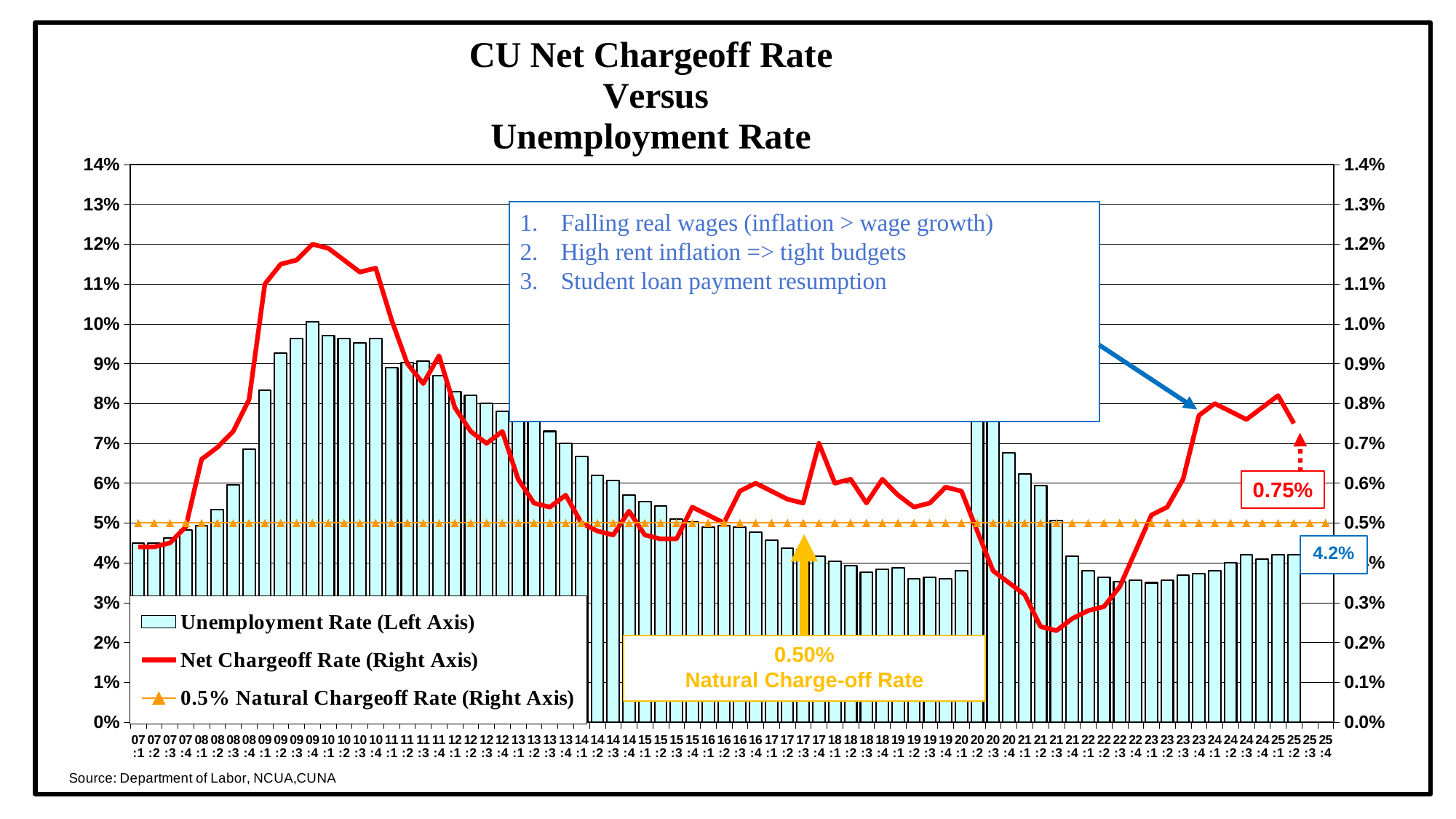
What is the most recent net chargeoff rate value labeled on the chart? 0.75% Does the net chargeoff rate rise or fall between 21:2 and 24:1? rise On which axis is the unemployment rate plotted? Left axis What kind of chart is shown on the slide? A combination bar and line chart Which is larger, the unemployment rate for 09:4 or for 19:4? 09:4 Is the net chargeoff rate for 09:4 greater or less than 1.1%? greater What value is given for the natural charge-off rate? 0.50% What is the most recent unemployment rate value labeled on the chart? 4.2% How many series does the legend list? 3 What is the highest tick value shown on the right axis? 1.4% Is the unemployment rate for 13:1 greater or less than 7%? greater Is the net chargeoff rate for 21:2 greater or less than 0.3%? less